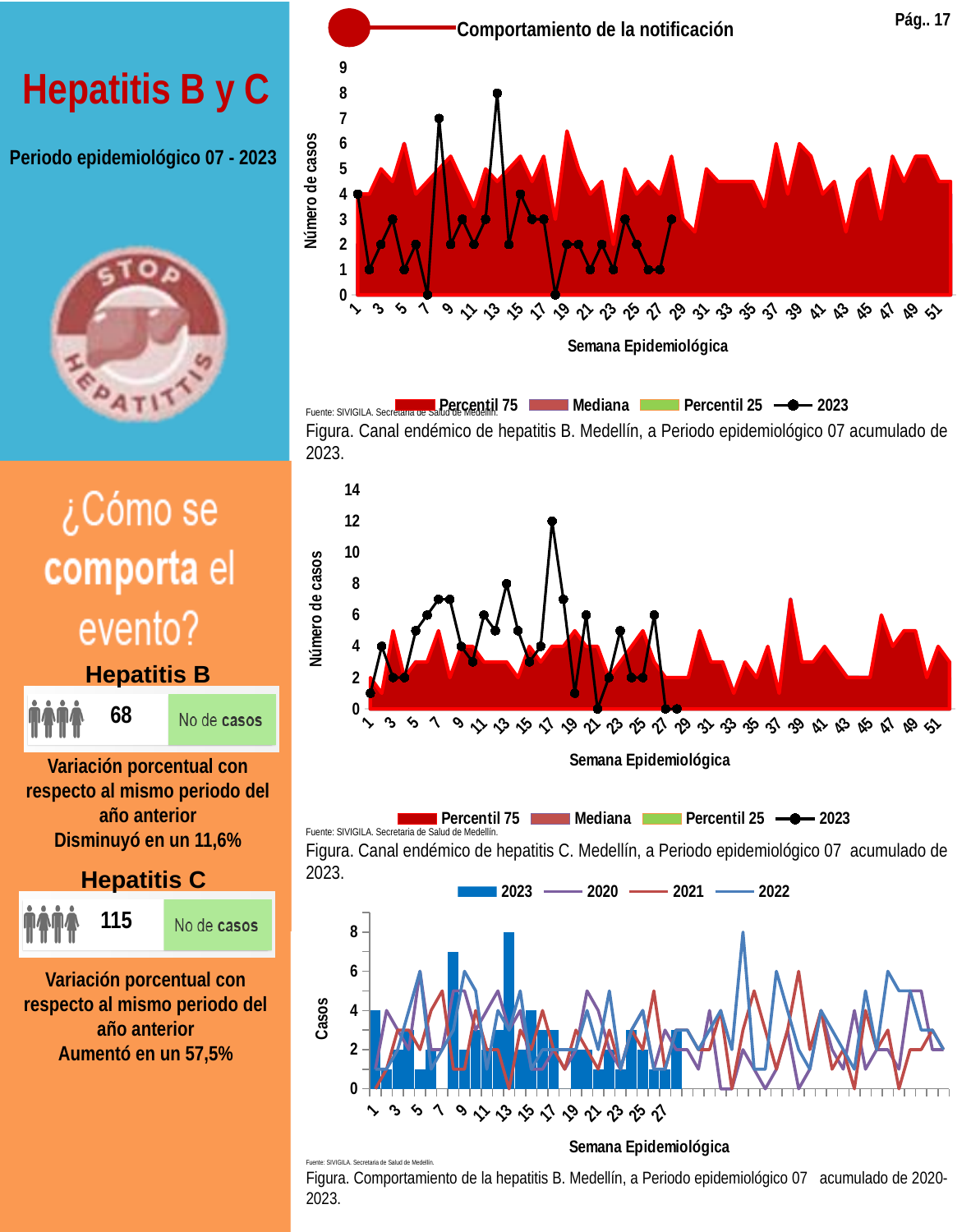
In the top chart (Canal endémico de hepatitis B), what is the value of the 2023 line at week 7? 0 In the bottom chart (Comportamiento de la hepatitis B 2020-2023), what kind of chart is used for the 2023 series? bar chart In the middle chart (Canal endémico de hepatitis C), is the value of the 2023 line at week 17 greater or less than 10? greater In the middle chart (Canal endémico de hepatitis C), what is the value of the 2023 line at week 17? 12 In the top chart (Canal endémico de hepatitis B), what is the value of the 2023 line at week 13? 8 In the middle chart (Canal endémico de hepatitis C), what is the value of the 2023 line at week 21? 0 Which series does the legend of the bottom chart (Comportamiento de la hepatitis B 2020-2023) list? 2023, 2020, 2021, 2022 In the top chart (Canal endémico de hepatitis B), which is larger for the 2023 line: the value at week 13 or the value at week 8? week 13 In the bottom chart (Comportamiento de la hepatitis B 2020-2023), at which epidemiological week is the 2023 bar highest? 13 In the top chart (Canal endémico de hepatitis B), at which epidemiological week does the 2023 line reach its highest value? 13 How many series does the legend of the top chart (Canal endémico de hepatitis B) list? 4 In the middle chart (Canal endémico de hepatitis C), at which epidemiological week does the 2023 line reach its highest value? 17